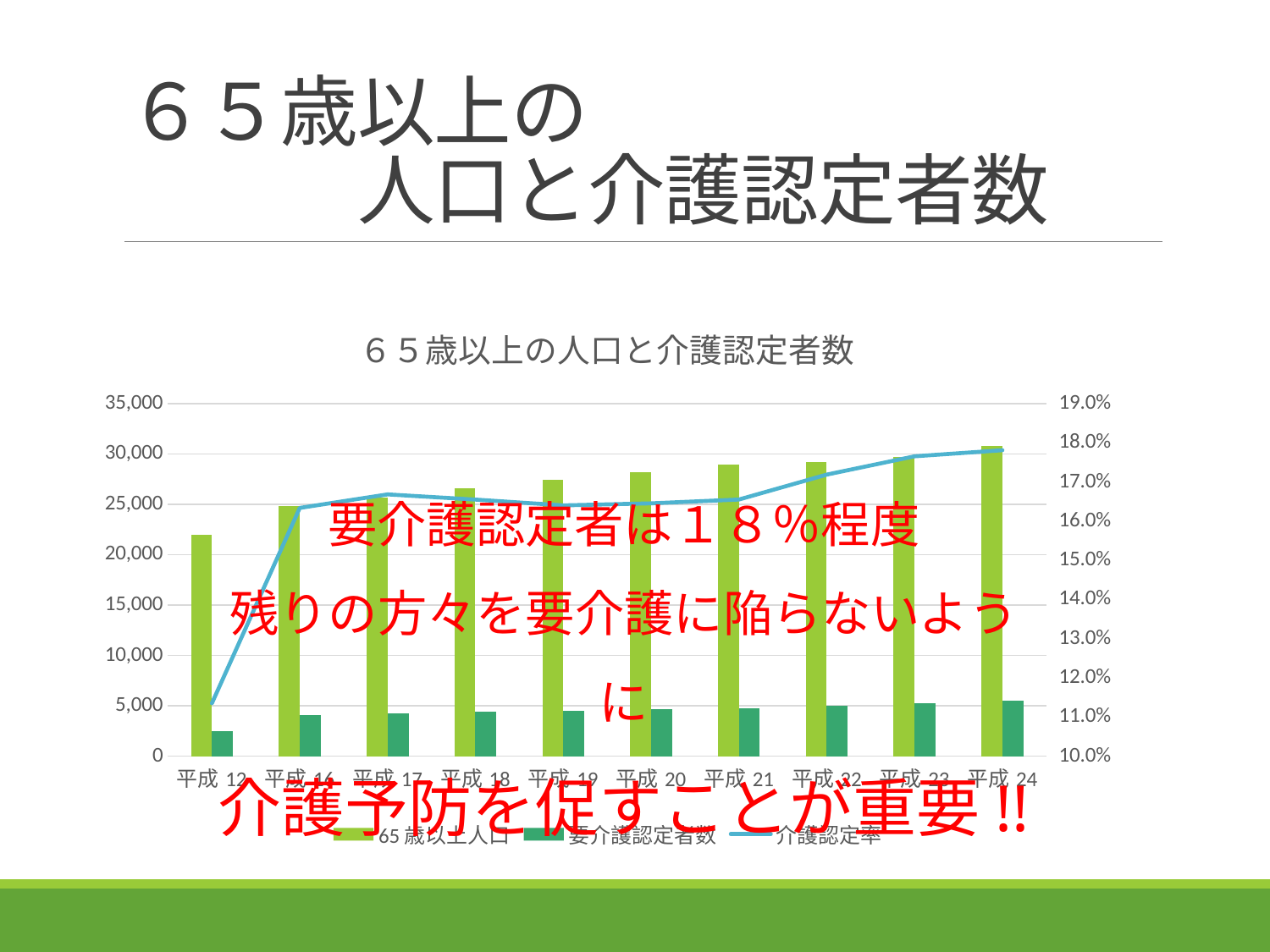
Which year has the highest value for 65歳以上人口? 平成 24 Is the value for 65歳以上人口 in 平成 12 greater or less than 20,000? greater Is the 介護認定率 in 平成 12 greater or less than 12.0%? less Is the value for 要介護認定者数 in 平成 12 greater or less than 5,000? less How many series does the legend list? 3 Which year has a larger value for 65歳以上人口, 平成 12 or 平成 24? 平成 24 What is the title of the chart? ６５歳以上の人口と介護認定者数 How many year categories are shown on the x axis? 10 What kind of chart is shown on the slide? A combination bar and line chart Which year has the lowest value for 65歳以上人口? 平成 12 Does the value for 65歳以上人口 generally rise or fall from 平成 12 to 平成 24? rise